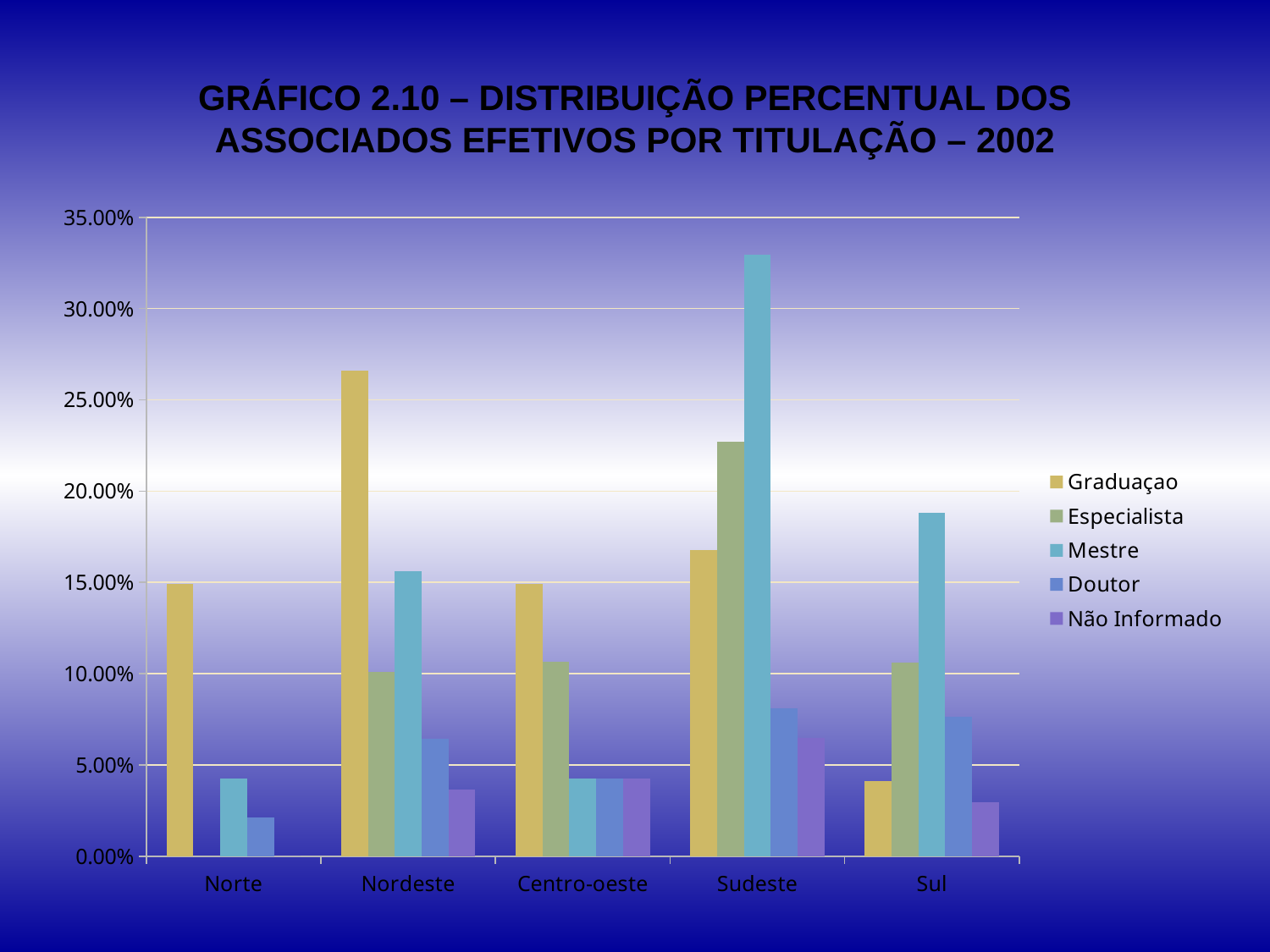
Which year does the chart title refer to? 2002 How many regions are shown on the x axis? 5 Is the value for Mestre in Sudeste greater or less than 30.00%? greater Which region has the highest value for Graduaçao? Nordeste How many series does the legend list? 5 Is the value for Mestre in Sul greater or less than 20.00%? less Which region has the highest value for Mestre? Sudeste Which region has the lowest value for Graduaçao? Sul In Sudeste, which is larger: Especialista or Mestre? Mestre Is the value for Graduaçao in Nordeste greater or less than 25.00%? greater What kind of chart is shown on the slide? bar chart In Nordeste, which is larger: Graduaçao or Mestre? Graduaçao